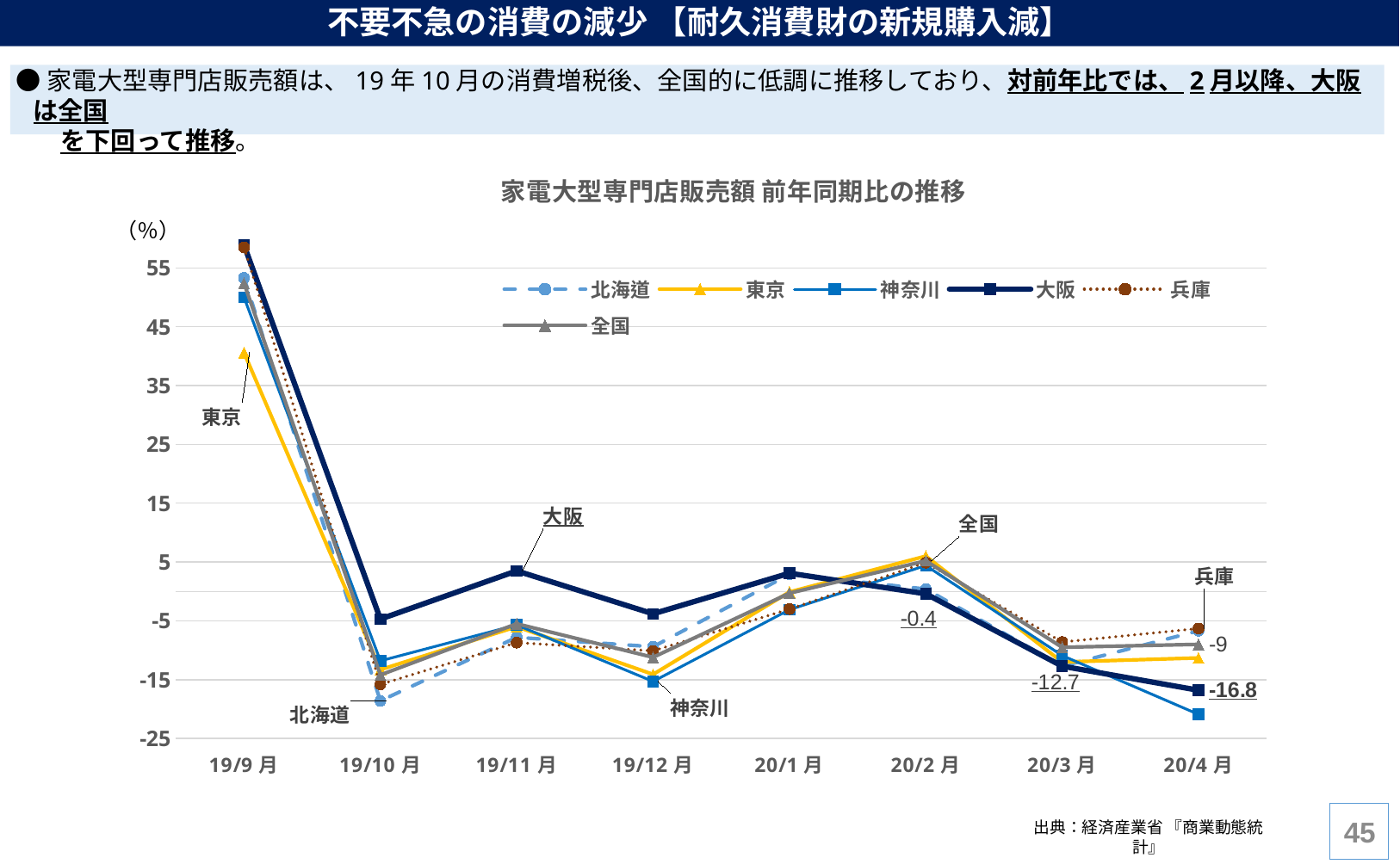
Which series has the lowest value in 20/4月? 神奈川 What is the value for 大阪 in 20/4月? -16.8 Does the 大阪 line rise or fall from 20/2月 to 20/4月? fall What kind of chart is shown on the slide? line chart How many months are shown on the x axis? 8 What is the value for 大阪 in 20/2月? -0.4 Is the value for 神奈川 in 20/4月 greater or less than -15? less How many series does the legend list? 6 Which series has the lowest value in 19/9月? 東京 What is the value for 全国 in 20/4月? -9 What is the difference between the 全国 value and the 大阪 value in 20/4月? 7.8 What is the value for 大阪 in 20/3月? -12.7